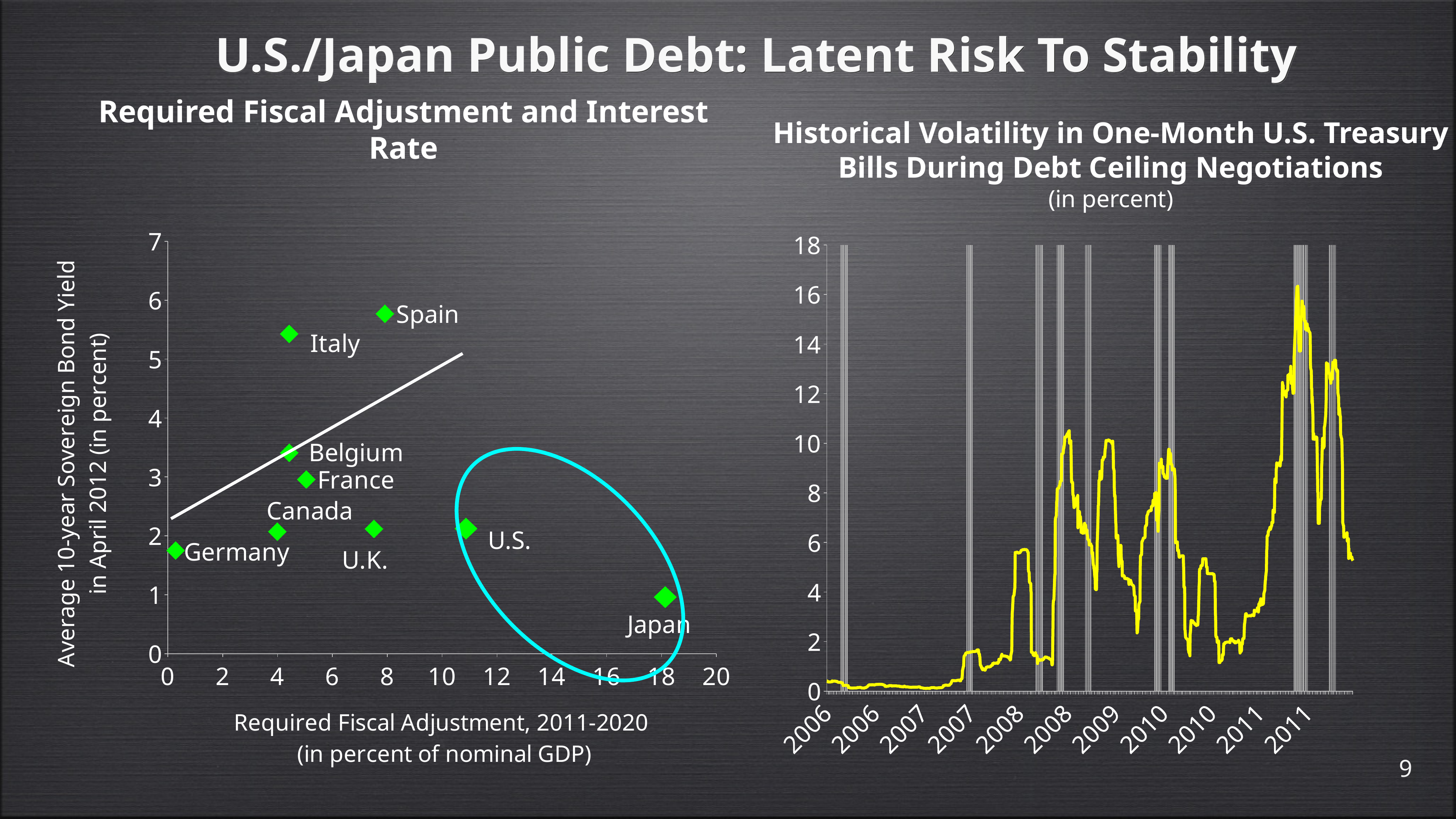
On the left chart, Required Fiscal Adjustment and Interest Rate, is Germany's bond yield greater or less than 2? less On the left chart, Required Fiscal Adjustment and Interest Rate, how many countries are plotted? 9 On the right chart, Historical Volatility in One-Month U.S. Treasury Bills, is the peak value reached in 2011 greater or less than 14? greater On the left chart, Required Fiscal Adjustment and Interest Rate, is Japan's required fiscal adjustment greater or less than 16? greater On the right chart, Historical Volatility in One-Month U.S. Treasury Bills, what colour is the plotted line? yellow On the left chart, Required Fiscal Adjustment and Interest Rate, which country has the smallest required fiscal adjustment? Germany On the left chart, Required Fiscal Adjustment and Interest Rate, which has the higher bond yield, Italy or the U.S.? Italy On the left chart, Required Fiscal Adjustment and Interest Rate, which country has the lowest average 10-year sovereign bond yield? Japan On the left chart, Required Fiscal Adjustment and Interest Rate, which country has the highest average 10-year sovereign bond yield? Spain What kind of chart is the right chart, Historical Volatility in One-Month U.S. Treasury Bills During Debt Ceiling Negotiations? line chart On the left chart, Required Fiscal Adjustment and Interest Rate, which country has the largest required fiscal adjustment? Japan